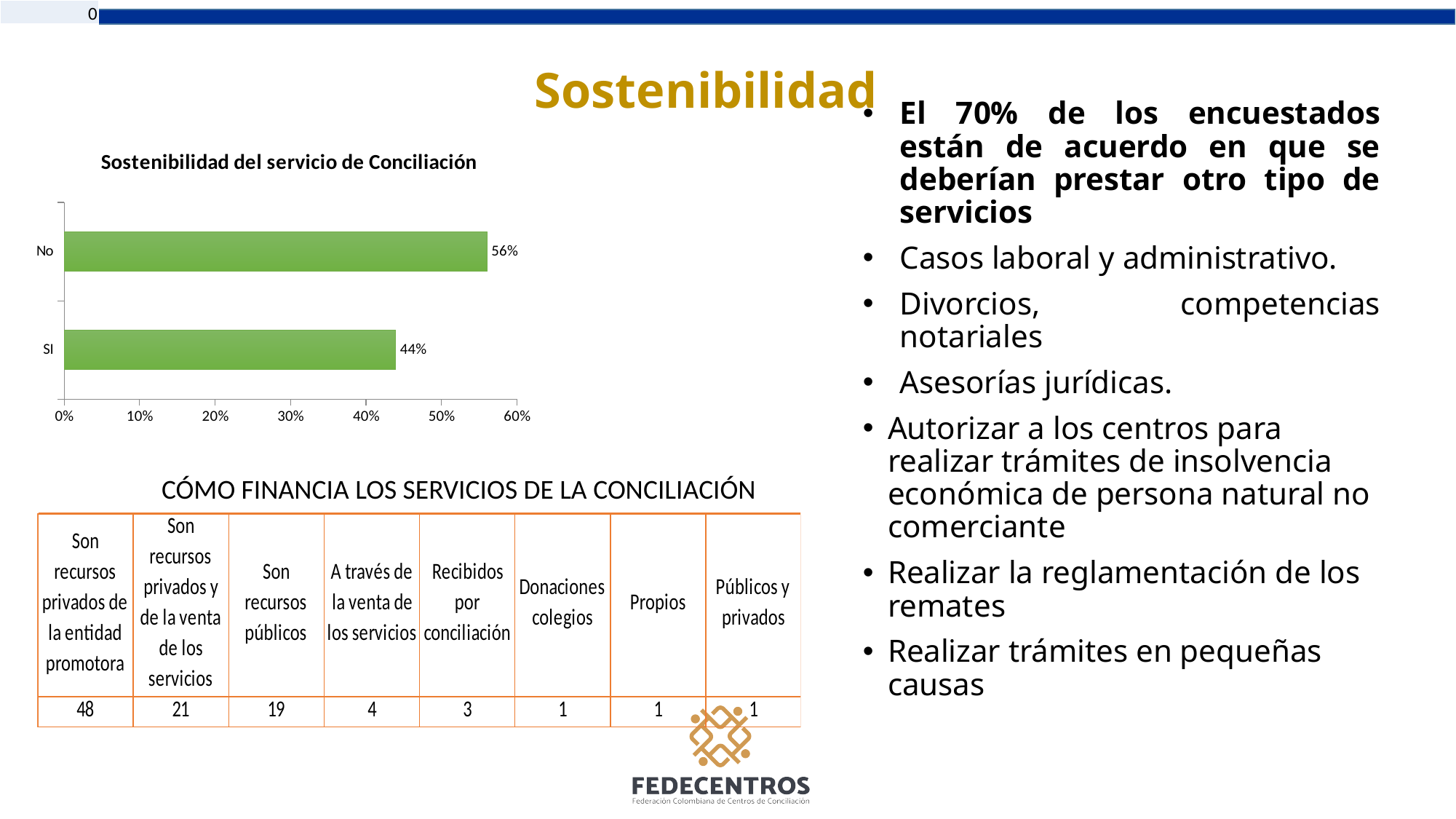
In the chart "Sostenibilidad del servicio de Conciliación", is the value for "No" greater or less than 50%? greater What is the value for "SI" in the chart "Sostenibilidad del servicio de Conciliación"? 44% Which category has the lowest value in the chart "Sostenibilidad del servicio de Conciliación"? SI What kind of chart is "Sostenibilidad del servicio de Conciliación"? bar chart What is the title of the chart on the slide? Sostenibilidad del servicio de Conciliación How many categories are shown in the chart "Sostenibilidad del servicio de Conciliación"? 2 What is the value for "No" in the chart "Sostenibilidad del servicio de Conciliación"? 56% What is the difference between the values for "No" and "SI" in the chart "Sostenibilidad del servicio de Conciliación"? 12% In the chart "Sostenibilidad del servicio de Conciliación", is the value for "SI" greater or less than 50%? less In the chart "Sostenibilidad del servicio de Conciliación", which is larger, the value for "No" or the value for "SI"? No Which category has the highest value in the chart "Sostenibilidad del servicio de Conciliación"? No What is the maximum value shown on the x axis of the chart "Sostenibilidad del servicio de Conciliación"? 60%